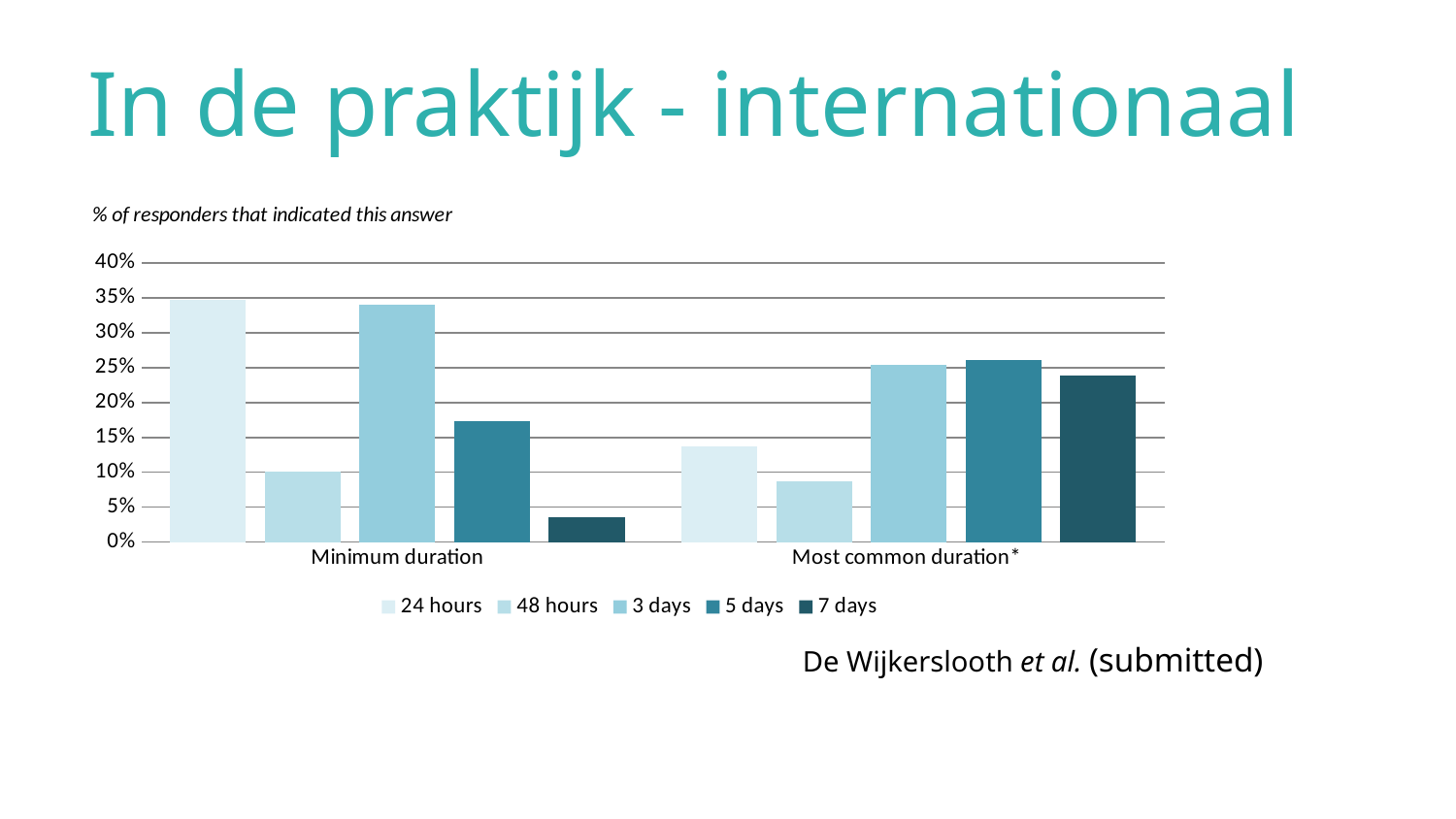
Is the value for 3 days under Most common duration* greater or less than 20%? greater Which is larger: the 24 hours value for Minimum duration or the 24 hours value for Most common duration*? Minimum duration Which series has the lowest value for Minimum duration? 7 days How many series does the legend list? 5 What does the text above the chart say the values represent? % of responders that indicated this answer What kind of chart is shown on the slide? bar chart How many categories are shown on the x axis? 2 Is the value for 24 hours under Minimum duration greater or less than 30%? greater Which series has the lowest value for Most common duration*? 48 hours Is the value for 7 days under Minimum duration greater or less than 5%? less Which is larger: the 5 days value for Minimum duration or the 5 days value for Most common duration*? Most common duration*